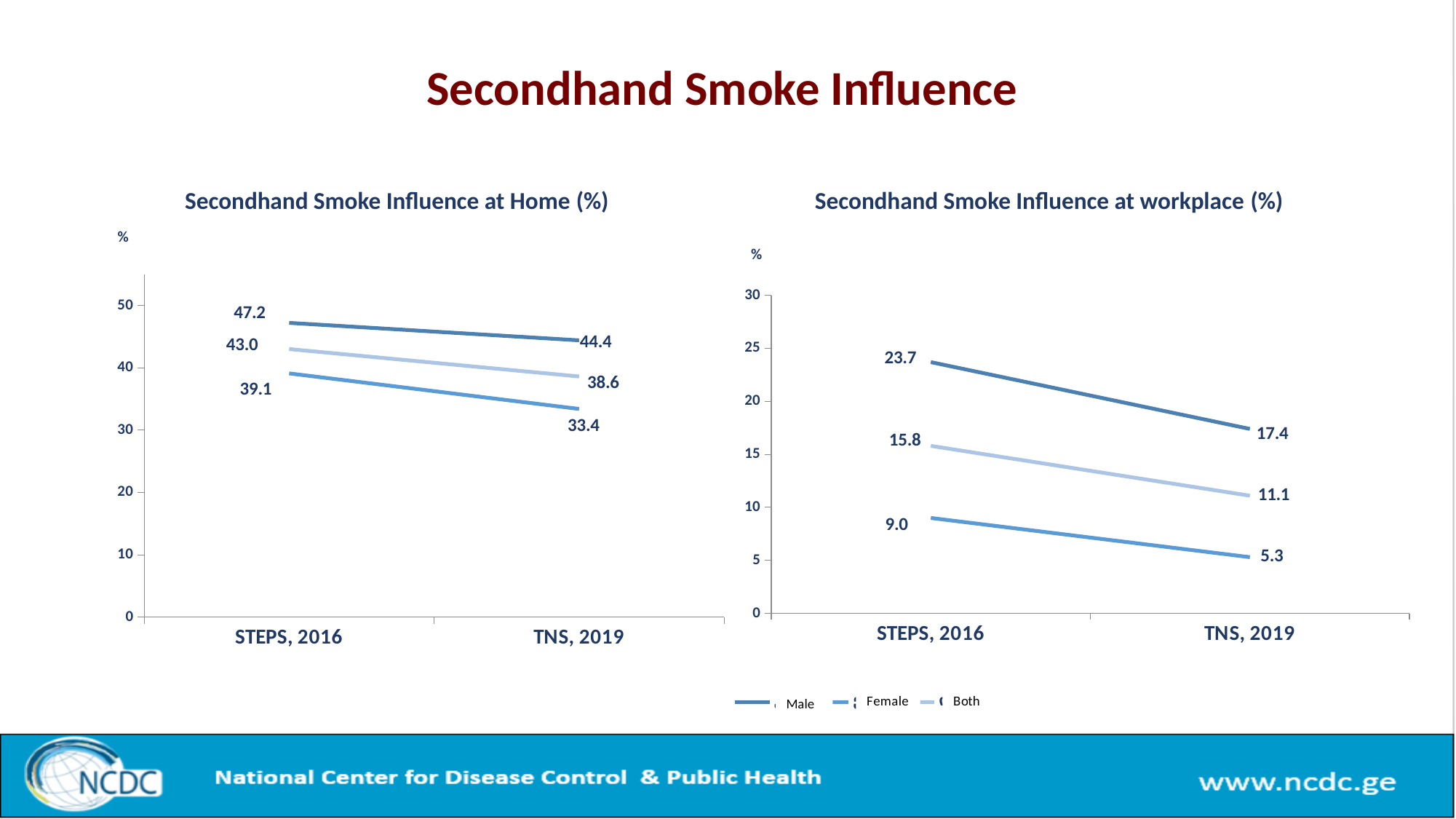
In the 'Secondhand Smoke Influence at workplace (%)' chart, what is the value for Both in STEPS, 2016? 15.8 In the 'Secondhand Smoke Influence at workplace (%)' chart, does the Both series rise or fall from STEPS, 2016 to TNS, 2019? fall In the 'Secondhand Smoke Influence at Home (%)' chart, which series has the highest value in STEPS, 2016? Male In the 'Secondhand Smoke Influence at workplace (%)' chart, which series has the lowest value in TNS, 2019? Female In the 'Secondhand Smoke Influence at Home (%)' chart, what is the value for Female in TNS, 2019? 33.4 In the 'Secondhand Smoke Influence at workplace (%)' chart, what is the difference between the Male and Female values in STEPS, 2016? 14.7 In the 'Secondhand Smoke Influence at Home (%)' chart, is the Female value in TNS, 2019 larger or smaller than the Both value in TNS, 2019? smaller In the 'Secondhand Smoke Influence at Home (%)' chart, what is the value for Male in STEPS, 2016? 47.2 What type of chart is 'Secondhand Smoke Influence at Home (%)'? line chart In the 'Secondhand Smoke Influence at workplace (%)' chart, what is the value for Male in TNS, 2019? 17.4 In the 'Secondhand Smoke Influence at Home (%)' chart, what is the difference between the Male values in STEPS, 2016 and TNS, 2019? 2.8 How many series does the legend list? 3